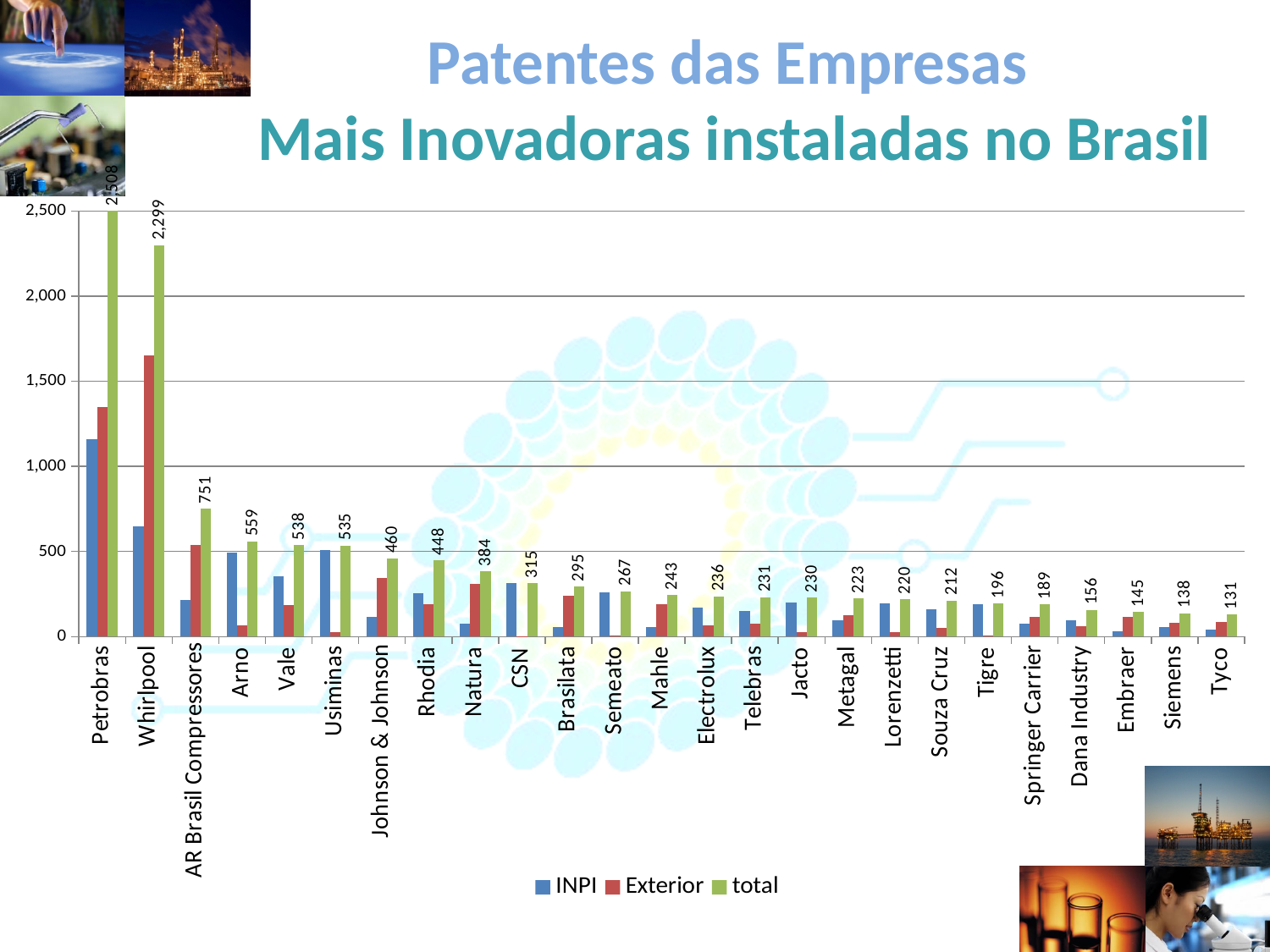
Is the Exterior value for Whirlpool greater or less than 1,500? greater What is the total value shown for Petrobras? 2,508 What kind of chart is shown on the slide? bar chart How many companies are shown on the x axis? 25 What is the total value shown for Vale? 538 Which company has the highest total? Petrobras Which has the larger total, Arno or Vale? Arno What is the difference between the total for Petrobras and the total for Whirlpool? 209 Which company has the lowest total? Tyco Is the INPI value for Petrobras greater or less than 1,000? greater What is the total value shown for Embraer? 145 How many series does the legend list? 3